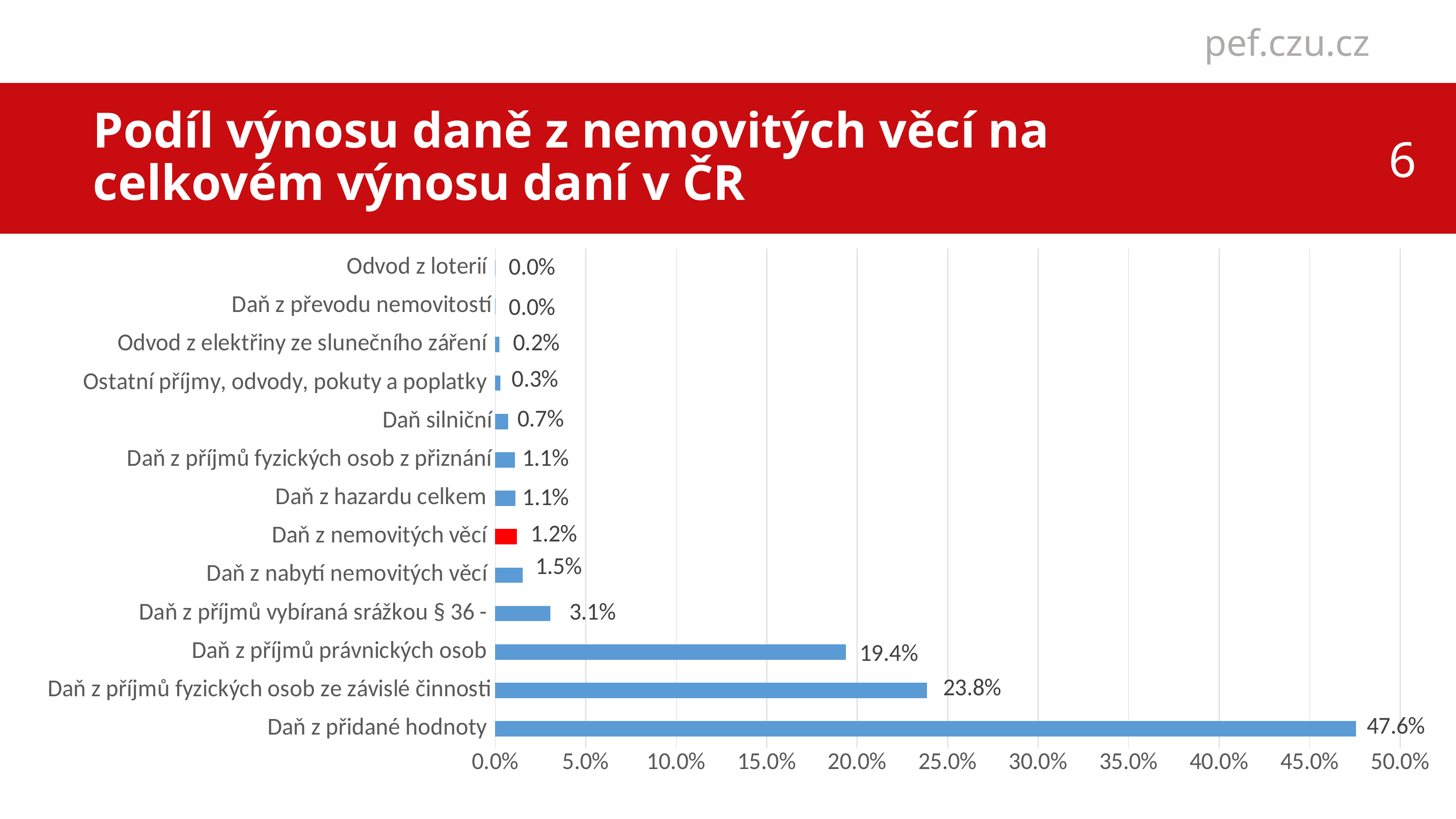
How many categories are shown in the chart? 13 What is the difference between Daň z příjmů vybíraná srážkou § 36 - and Daň z nemovitých věcí? 1.9% Is the value for Daň z příjmů právnických osob greater or less than 20.0%? less What is the value for Daň z příjmů právnických osob? 19.4% What is the value for Daň silniční? 0.7% Which category has the highest value? Daň z přidané hodnoty Which bar is coloured red instead of blue? Daň z nemovitých věcí What is the difference between Daň z přidané hodnoty and Daň z příjmů fyzických osob ze závislé činnosti? 23.8% What is the value for Daň z přidané hodnoty? 47.6% What is the value for Daň z nemovitých věcí? 1.2% Which is larger, Daň z nabytí nemovitých věcí or Daň z nemovitých věcí? Daň z nabytí nemovitých věcí What kind of chart is shown on the slide? bar chart